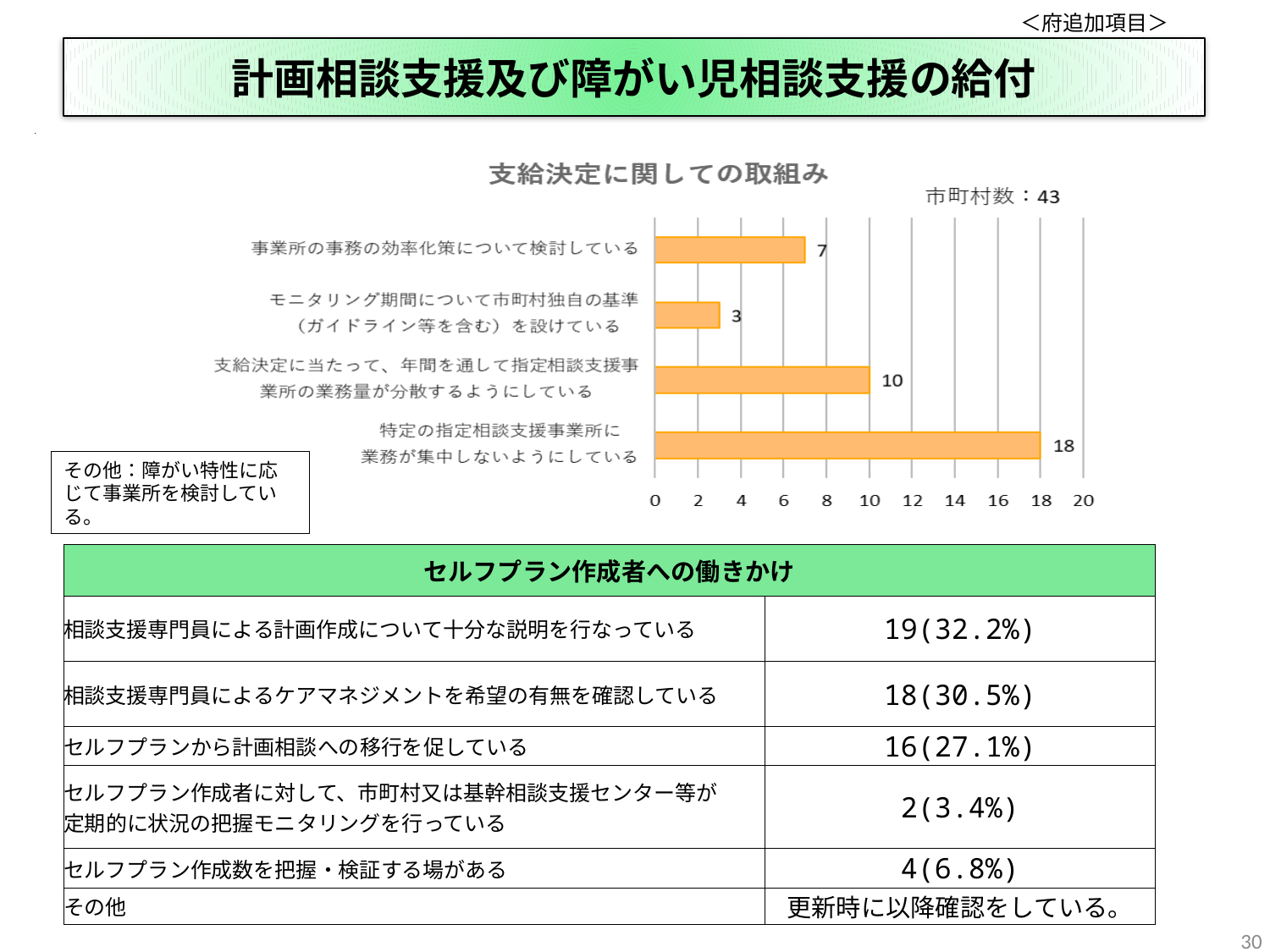
Which category has the highest value? 特定の指定相談支援事業所に業務が集中しないようにしている Which is larger: the value for 支給決定に当たって、年間を通して指定相談支援事業所の業務量が分散するようにしている or the value for 事業所の事務の効率化策について検討している? 支給決定に当たって、年間を通して指定相談支援事業所の業務量が分散するようにしている What is the value for 支給決定に当たって、年間を通して指定相談支援事業所の業務量が分散するようにしている? 10 What kind of chart is shown on the slide? bar chart What is the value for 特定の指定相談支援事業所に業務が集中しないようにしている? 18 What is the title of the chart? 支給決定に関しての取組み Is the value for 特定の指定相談支援事業所に業務が集中しないようにしている greater or less than 16? greater What is the value for モニタリング期間について市町村独自の基準（ガイドライン等を含む）を設けている? 3 What is the value for 事業所の事務の効率化策について検討している? 7 What is the difference between the values for 特定の指定相談支援事業所に業務が集中しないようにしている and 事業所の事務の効率化策について検討している? 11 How many categories are shown in the chart? 4 Which category has the lowest value? モニタリング期間について市町村独自の基準（ガイドライン等を含む）を設けている